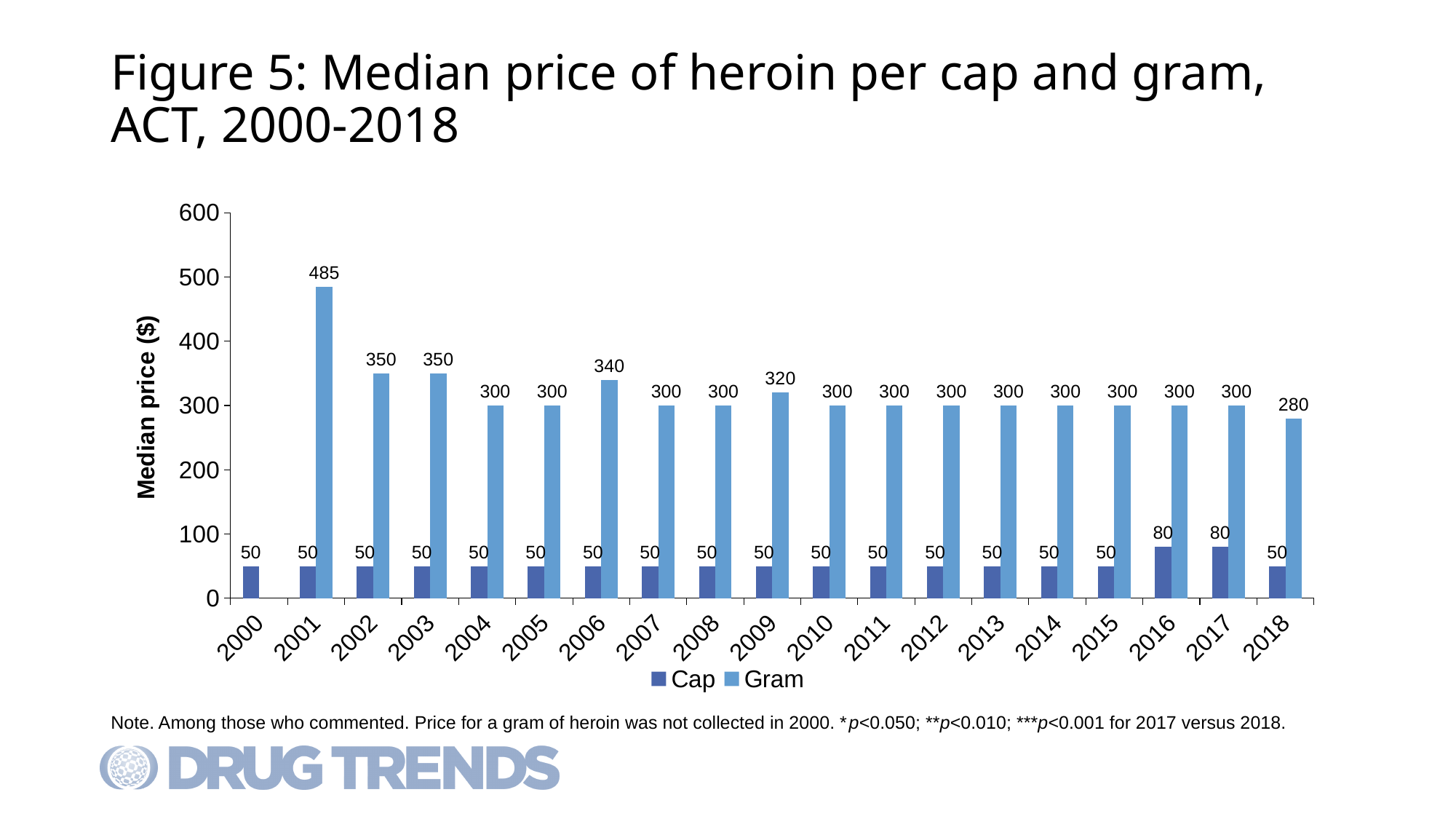
In which year is the median price per gram highest? 2001 What is the difference between the median price per gram in 2001 and in 2002? 135 How many years are shown on the x axis? 19 What is the median price per gram of heroin in 2018? 280 What kind of chart is shown on the slide? Bar chart In which year is the median price per gram lowest? 2018 What is the median price per cap of heroin in 2016? 80 What is the label on the y axis? Median price ($) How many series does the legend list? 2 Which is larger, the median price per gram in 2006 or in 2009? 2006 What is the median price per gram of heroin in 2001? 485 What is the difference between the median price per cap in 2017 and in 2018? 30